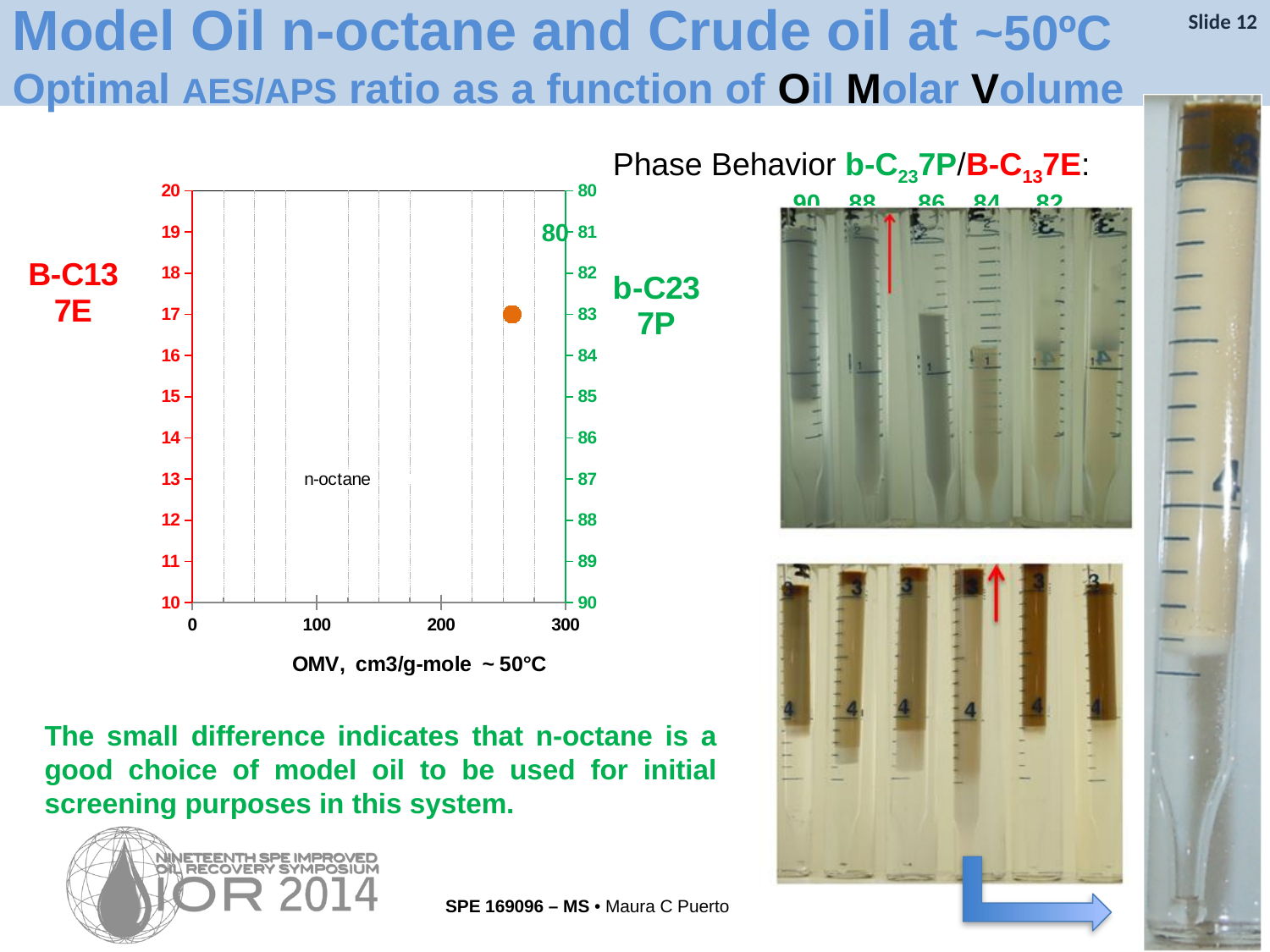
What is the maximum value shown on the x axis of the chart? 300 Is the OMV value of the plotted point greater or less than 200? greater On the left axis, is the value of the plotted point greater or less than 15? greater What is the x-axis title of the chart? OMV, cm3/g-mole ~ 50°C What text annotation appears inside the plot area of the chart? n-octane Is the OMV value of the plotted point greater or less than 300? less What label is written next to the left vertical axis of the chart? B-C13 7E How many data points are plotted on the chart? 1 What kind of chart is shown on the left of the slide? scatter chart What is the maximum value shown on the left vertical axis of the chart? 20